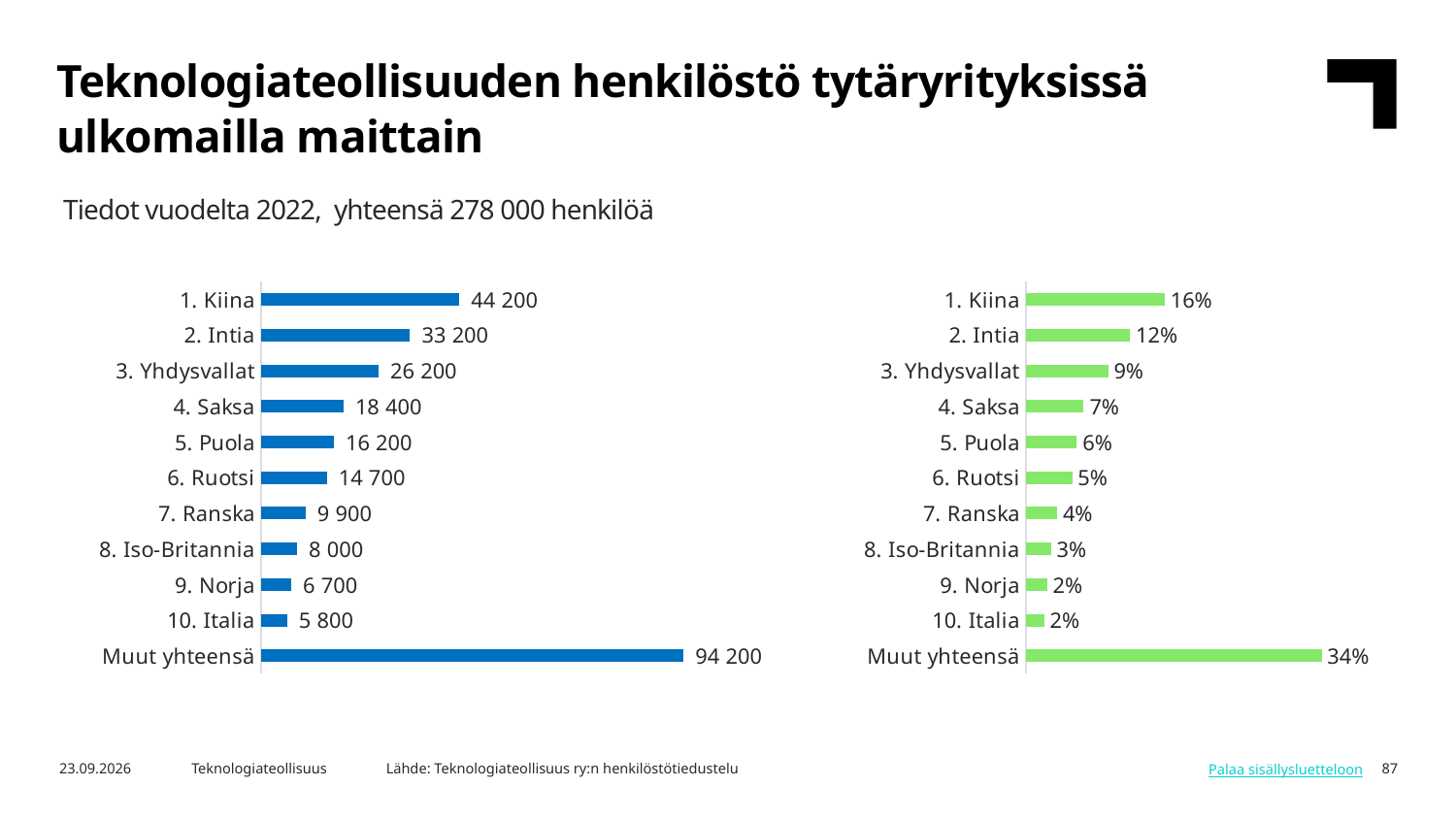
How many categories are shown in the left chart? 11 In the left chart, which category has the highest value? Muut yhteensä In the left chart, what is the difference between the values for 1. Kiina and 2. Intia? 11 000 What kind of chart is the right chart? Bar chart In the left chart, what is the value for 1. Kiina? 44 200 In the left chart, which category has the lowest value? 10. Italia In the left chart, which is larger, the value for 4. Saksa or the value for 5. Puola? 4. Saksa What colour are the bars in the right chart? Green In the left chart, what is the value for 6. Ruotsi? 14 700 In the right chart, what is the value for Muut yhteensä? 34% In the right chart, what is the value for 3. Yhdysvallat? 9% In the right chart, what is the difference between the values for 1. Kiina and 4. Saksa? 9%